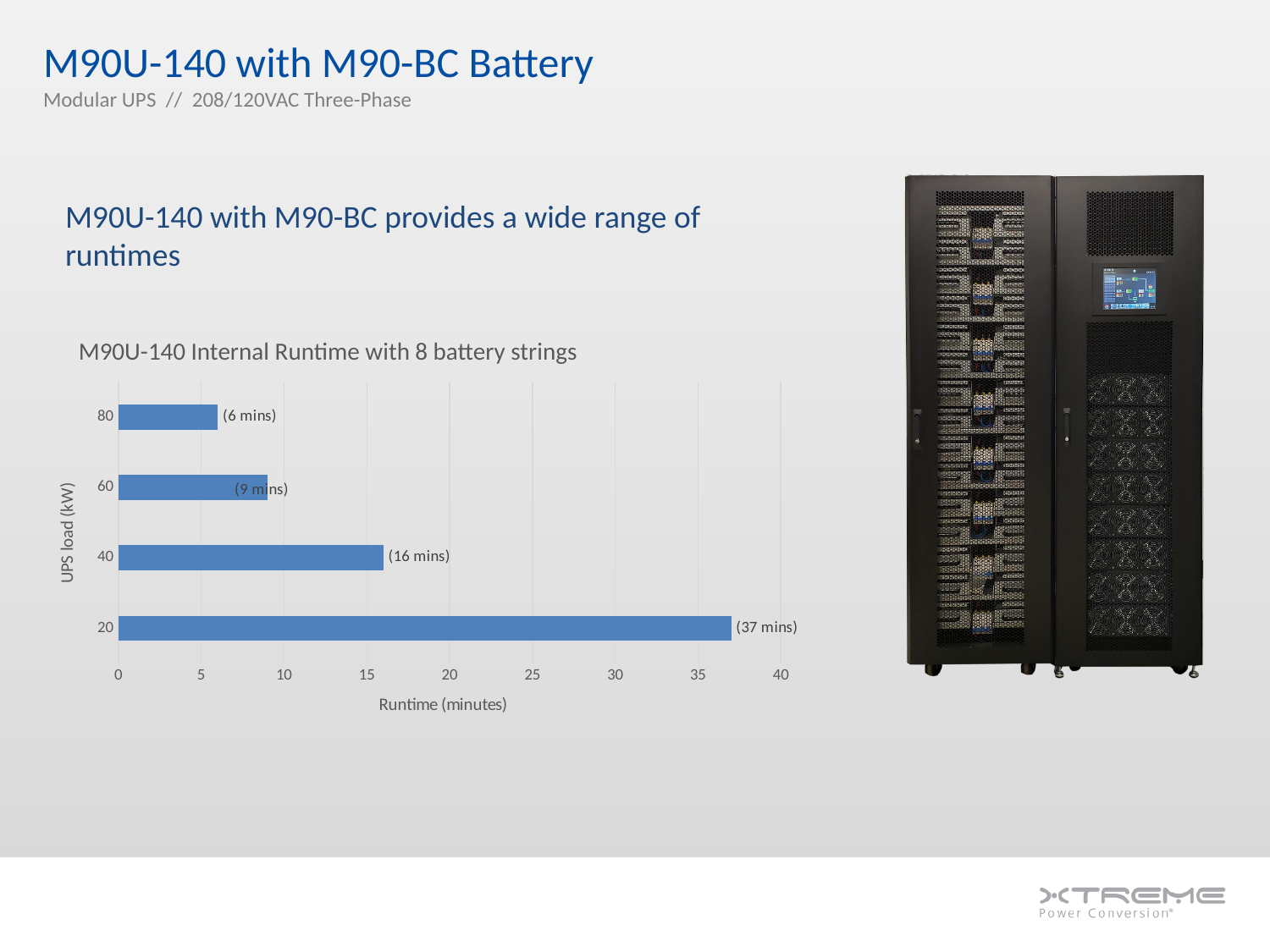
What is the title of the chart? M90U-140 Internal Runtime with 8 battery strings What is the runtime for a UPS load of 60 kW? 9 mins Is the runtime for a 20 kW load greater or less than 35 minutes? greater How many UPS load categories are shown in the chart? 4 Which UPS load has the longest runtime? 20 Which has a longer runtime, a 60 kW load or a 40 kW load? 40 kW What is the runtime for a UPS load of 80 kW? 6 mins How many minutes longer is the runtime at 20 kW than at 40 kW? 21 mins What is the runtime for a UPS load of 20 kW? 37 mins Which UPS load has the shortest runtime? 80 What is the runtime for a UPS load of 40 kW? 16 mins What kind of chart is shown on the slide? Bar chart